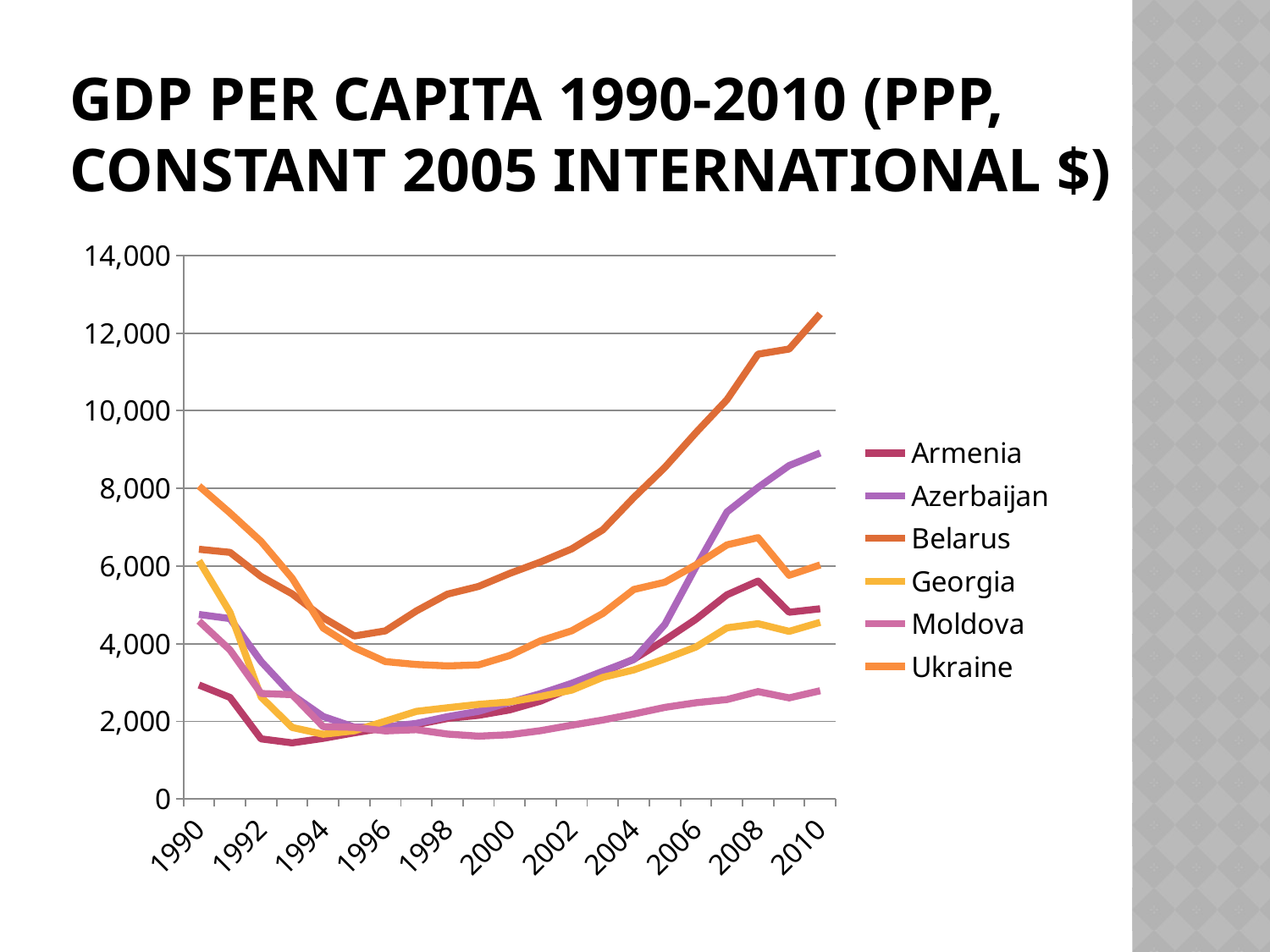
Which country has the lowest GDP per capita in 1990? Armenia Which country has the highest GDP per capita in 1990? Ukraine How many countries (series) does the legend list? 6 Is the value for Ukraine in 1990 greater or less than 6,000? greater What kind of chart is shown on the slide? Line chart Does the line for Belarus rise or fall between 1996 and 2010? Rise In 2010, which is larger: the value for Azerbaijan or the value for Ukraine? Azerbaijan Is the value for Moldova in 2010 greater or less than 4,000? less What is the title of the chart? GDP PER CAPITA 1990-2010 (PPP, CONSTANT 2005 INTERNATIONAL $) Is the value for Belarus in 2010 greater or less than 10,000? greater Which country has the lowest GDP per capita in 2010? Moldova Which country has the highest GDP per capita in 2010? Belarus